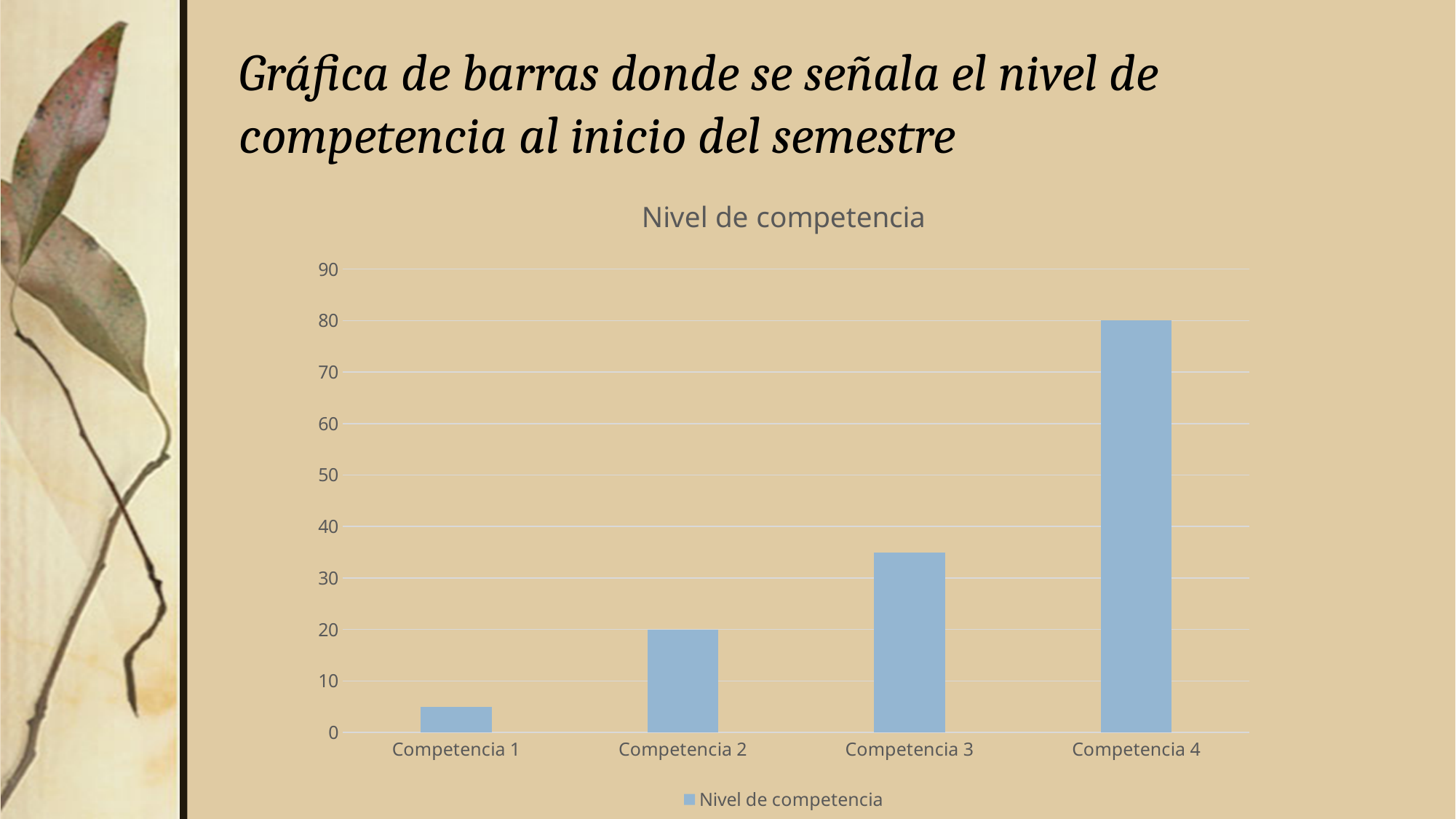
Is the value for Competencia 1 greater or less than 10? less What is the value for Competencia 4? 80 Which category has the highest value? Competencia 4 Is the value for Competencia 3 greater or less than 30? greater What is the difference between the values for Competencia 4 and Competencia 2? 60 What type of chart is shown on the slide? Bar chart Do the values rise or fall from Competencia 1 to Competencia 4? Rise How many categories are shown on the x axis of the chart? 4 What is the value for Competencia 2? 20 What is the title of the chart? Nivel de competencia Which category has the lowest value? Competencia 1 How many series does the legend list? 1